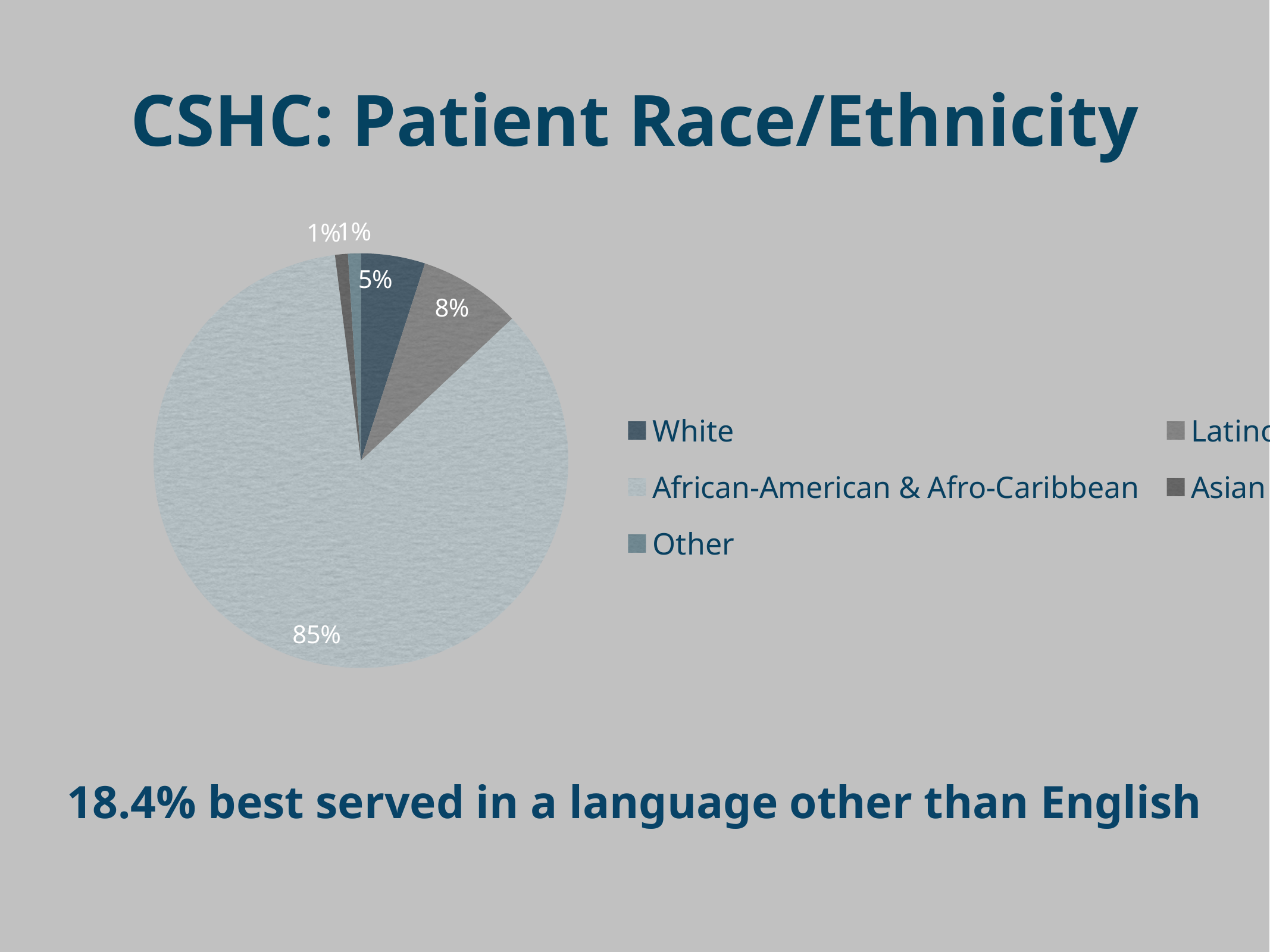
What is the value shown for White? 5% Which category has the largest slice of the pie? African-American & Afro-Caribbean What is the title of the slide? CSHC: Patient Race/Ethnicity What is the difference between the African-American & Afro-Caribbean share and the White share? 80 percentage points How many slices does the pie chart have? 5 What share of the pie does African-American & Afro-Caribbean represent? 85% How many entries does the legend list? 5 What is the value shown for Other? 1% What is the value shown for Asian? 1% What kind of chart is shown on the slide? Pie chart Which is larger, the White slice or the Asian slice? White What is the difference between the White share and the Other share? 4 percentage points